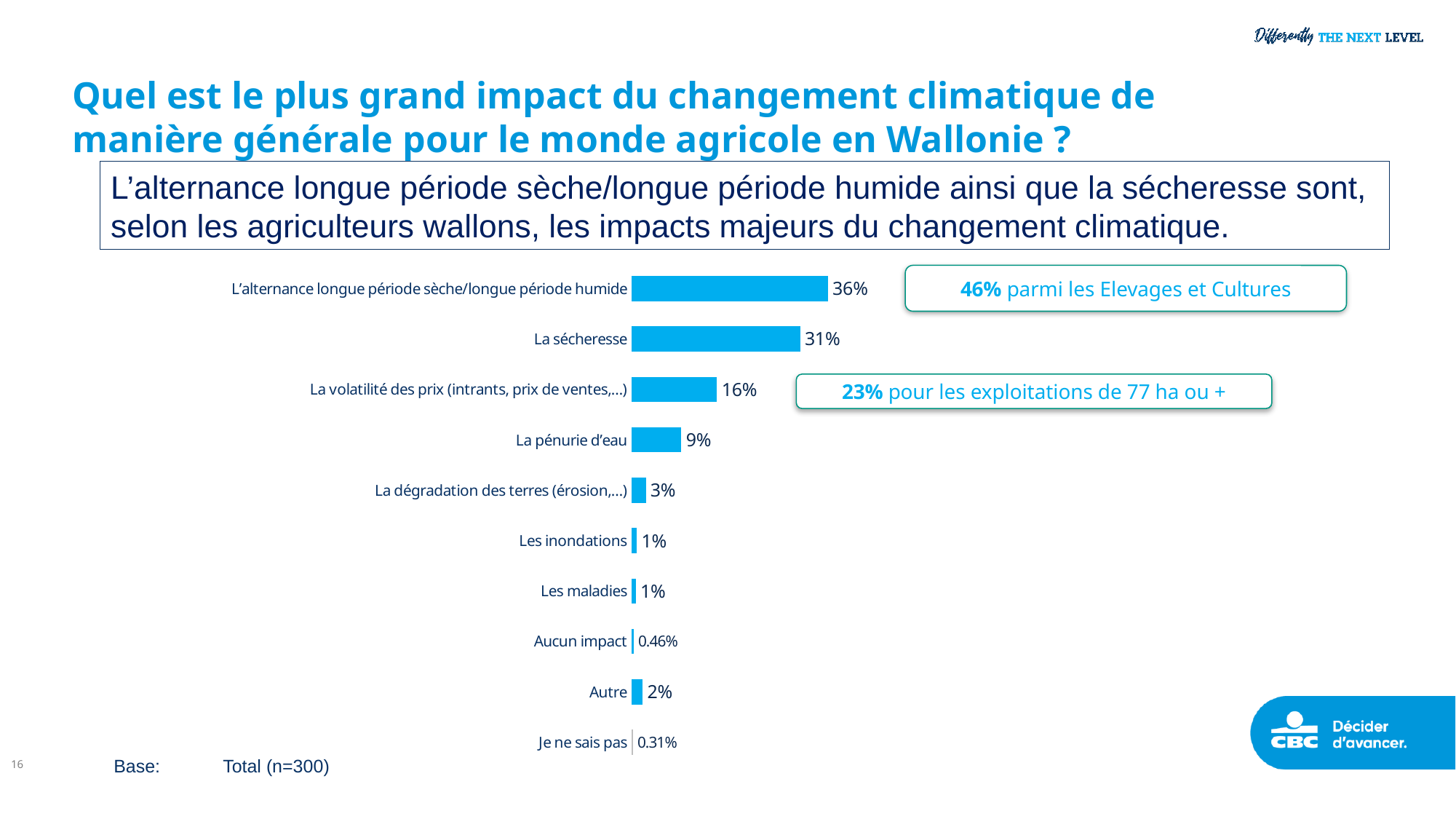
What is the value for "Aucun impact"? 0.46% What is the difference between the values for "La volatilité des prix (intrants, prix de ventes,...)" and "La pénurie d'eau"? 7% What is the base (sample size) stated below the chart? Total (n=300) What is the value for "La sécheresse"? 31% What is the value for "Je ne sais pas"? 0.31% Which category has the highest value? L'alternance longue période sèche/longue période humide What kind of chart is shown on the slide? Bar chart How many categories does the chart show? 10 What is the value for "La volatilité des prix (intrants, prix de ventes,...)"? 16% What is the difference between the values for "L'alternance longue période sèche/longue période humide" and "La sécheresse"? 5% Which category has the lowest value? Je ne sais pas Which is larger, the value for "La pénurie d'eau" or the value for "La dégradation des terres (érosion,...)"? La pénurie d'eau